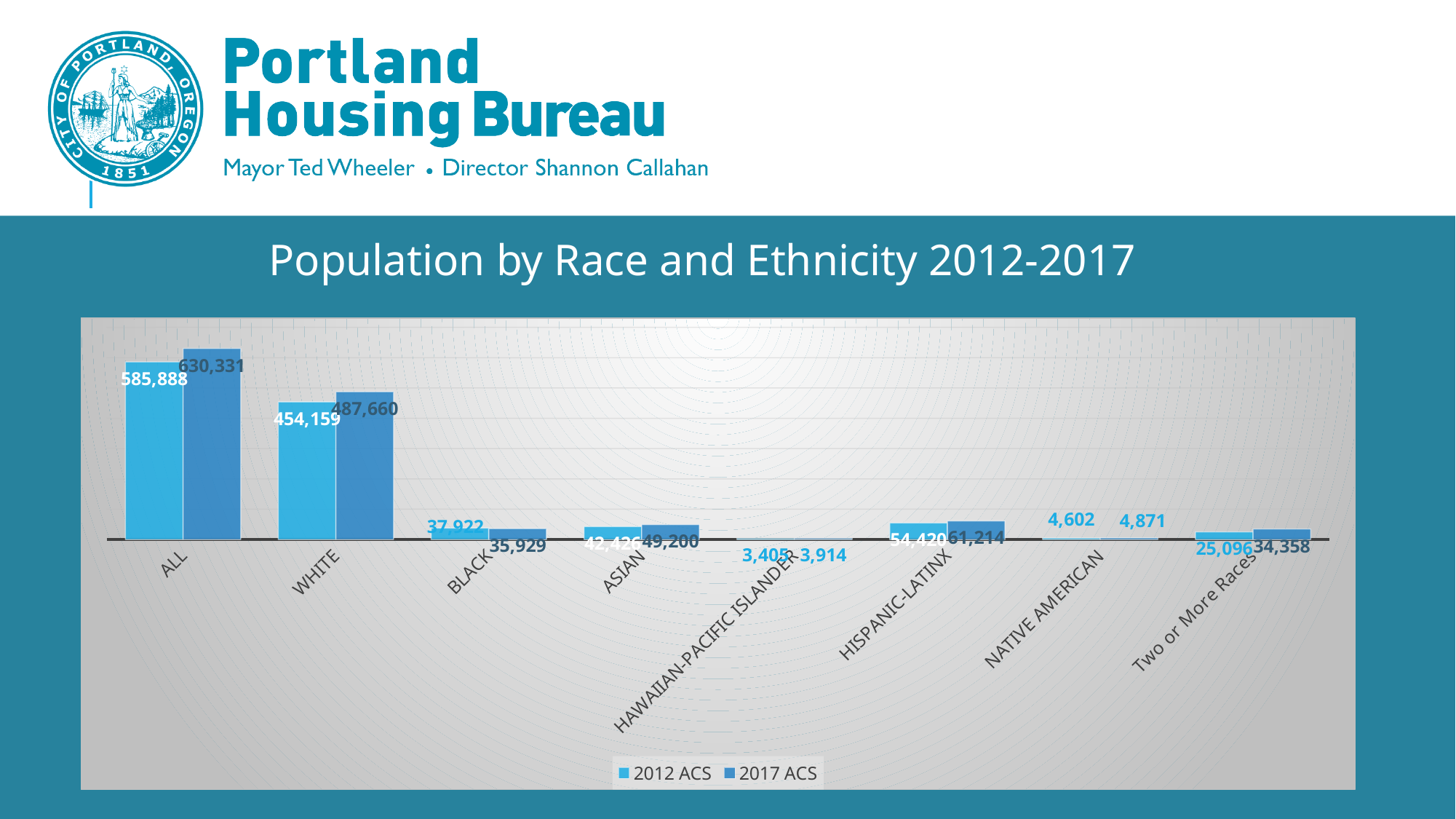
Excluding ALL, which category has the lowest 2017 ACS value? HAWAIIAN-PACIFIC ISLANDER Which is larger for BLACK, the 2012 ACS value or the 2017 ACS value? 2012 ACS What is the 2012 ACS value for WHITE? 454,159 What is the 2017 ACS value for ALL? 630,331 How many categories are shown on the x axis? 8 What type of chart is shown on the slide? bar chart What is the 2012 ACS value for NATIVE AMERICAN? 4,602 What is the 2017 ACS value for HISPANIC-LATINX? 61,214 What is the title of the chart? Population by Race and Ethnicity 2012-2017 What is the 2017 ACS value for Two or More Races? 34,358 How many series does the legend list? 2 What is the difference between the 2017 ACS and 2012 ACS values for ALL? 44,443